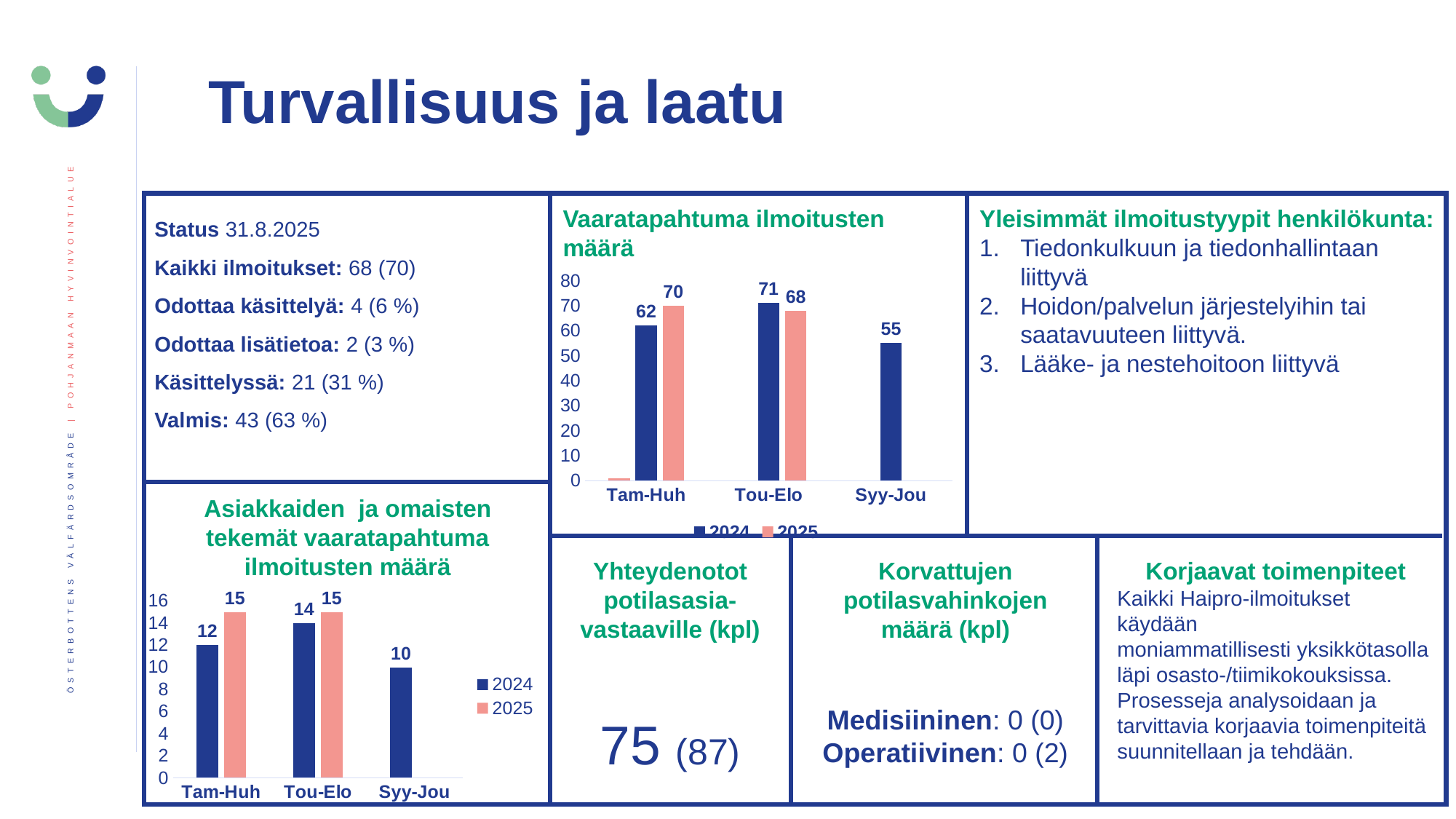
In the chart 'Vaaratapahtuma ilmoitusten määrä', what is the difference between the 2025 and 2024 values in Tam-Huh? 8 In the chart 'Asiakkaiden ja omaisten tekemät vaaratapahtuma ilmoitusten määrä', what is the difference between the 2025 and 2024 values in Tam-Huh? 3 In the chart 'Asiakkaiden ja omaisten tekemät vaaratapahtuma ilmoitusten määrä', what is the value for 2025 in Tam-Huh? 15 In the chart 'Vaaratapahtuma ilmoitusten määrä', what is the value for 2025 in Tou-Elo? 68 In the chart 'Vaaratapahtuma ilmoitusten määrä', what is the value for 2024 in Tam-Huh? 62 In the chart 'Vaaratapahtuma ilmoitusten määrä', how many series does the legend list? 2 In the chart 'Asiakkaiden ja omaisten tekemät vaaratapahtuma ilmoitusten määrä', which period has the lowest 2024 value? Syy-Jou In the chart 'Vaaratapahtuma ilmoitusten määrä', which period has the highest 2024 value? Tou-Elo In the chart 'Asiakkaiden ja omaisten tekemät vaaratapahtuma ilmoitusten määrä', what is the value for 2024 in Syy-Jou? 10 What kind of chart is 'Asiakkaiden ja omaisten tekemät vaaratapahtuma ilmoitusten määrä'? Bar chart In the chart 'Asiakkaiden ja omaisten tekemät vaaratapahtuma ilmoitusten määrä', how many periods are shown on the x axis? 3 In the chart 'Vaaratapahtuma ilmoitusten määrä', which is larger in Tou-Elo: 2024 or 2025? 2024